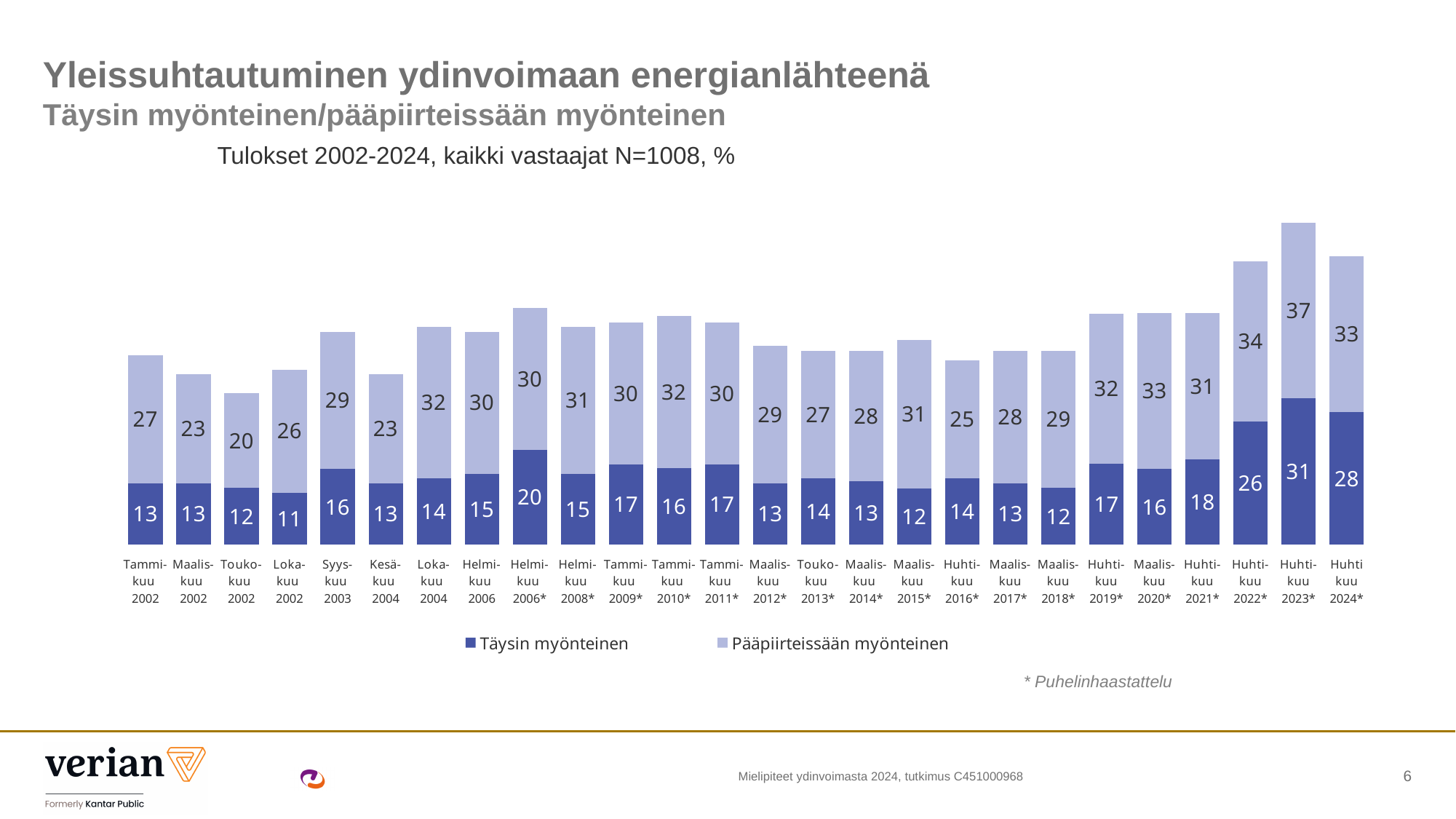
How many series does the legend list? 2 What is the total of the stacked bar for Toukokuu 2002? 32 How many periods (bars) are shown on the chart? 26 What kind of chart is shown on the slide? Stacked bar chart Which period has the lowest Täysin myönteinen value? Lokakuu 2002 What is the value of Täysin myönteinen for Huhtikuu 2024*? 28 What is the value of Pääpiirteissään myönteinen for Tammikuu 2002? 27 Which period has the highest Täysin myönteinen value? Huhtikuu 2023* What is the difference between the Täysin myönteinen values for Huhtikuu 2022* and Huhtikuu 2021*? 8 What is the total of the stacked bar for Huhtikuu 2023*? 68 Which period has the lowest Pääpiirteissään myönteinen value? Toukokuu 2002 Which is larger: the Pääpiirteissään myönteinen value for Lokakuu 2004 or for Helmikuu 2006? Lokakuu 2004